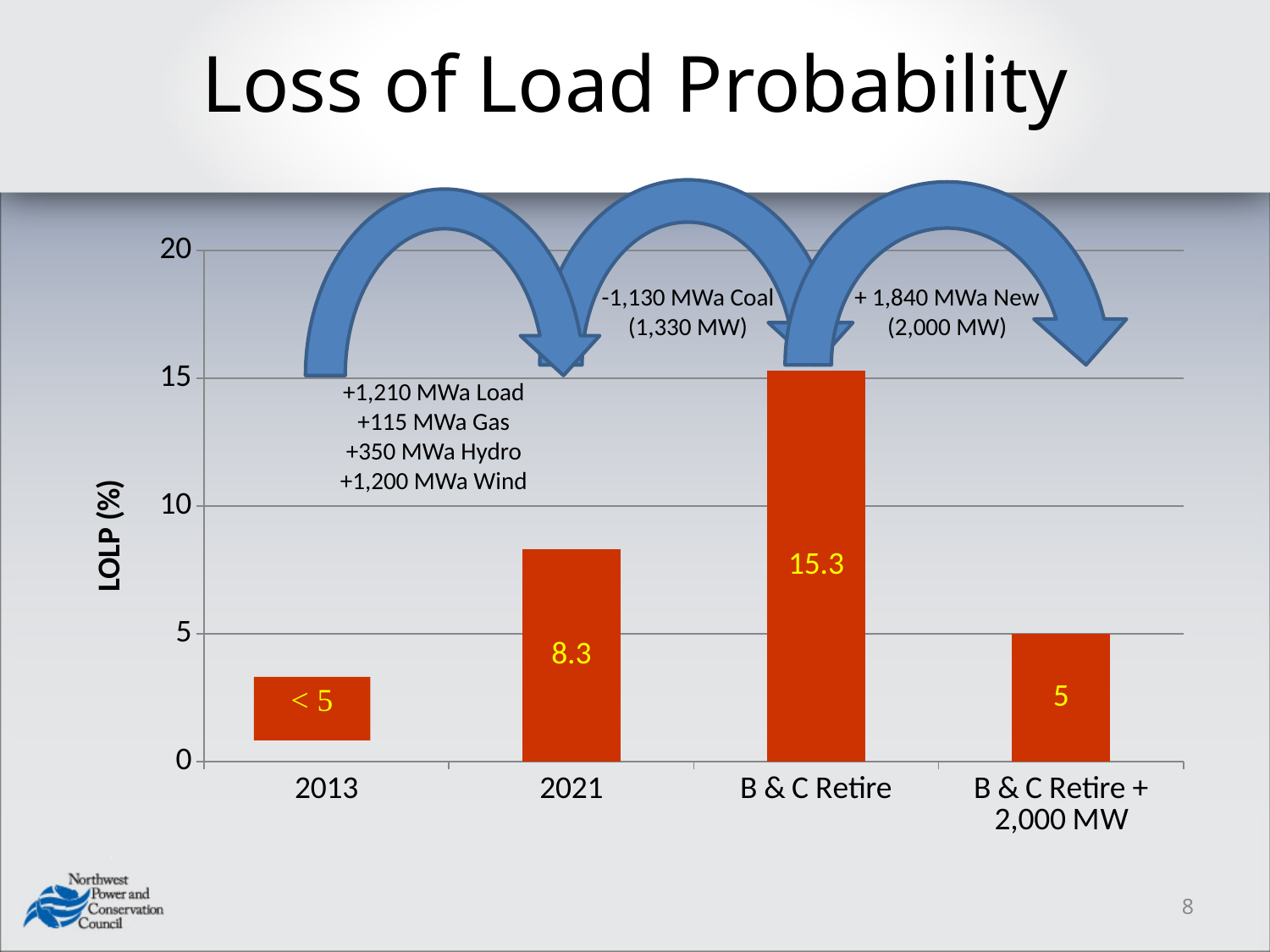
How many categories are shown on the x axis? 4 What is the difference in LOLP between B & C Retire and B & C Retire + 2,000 MW? 10.3 Which category has the lowest LOLP? 2013 What is the LOLP value shown for 2021? 8.3 What is the LOLP value shown for the B & C Retire scenario? 15.3 What label is printed on the 2013 bar? < 5 What kind of chart is shown on the slide? bar chart Which has a higher LOLP, 2021 or B & C Retire + 2,000 MW? 2021 What is the LOLP value shown for the B & C Retire + 2,000 MW scenario? 5 What is the difference in LOLP between B & C Retire and 2021? 7 Is the value for 2013 greater or less than 5? less Which category has the highest LOLP? B & C Retire